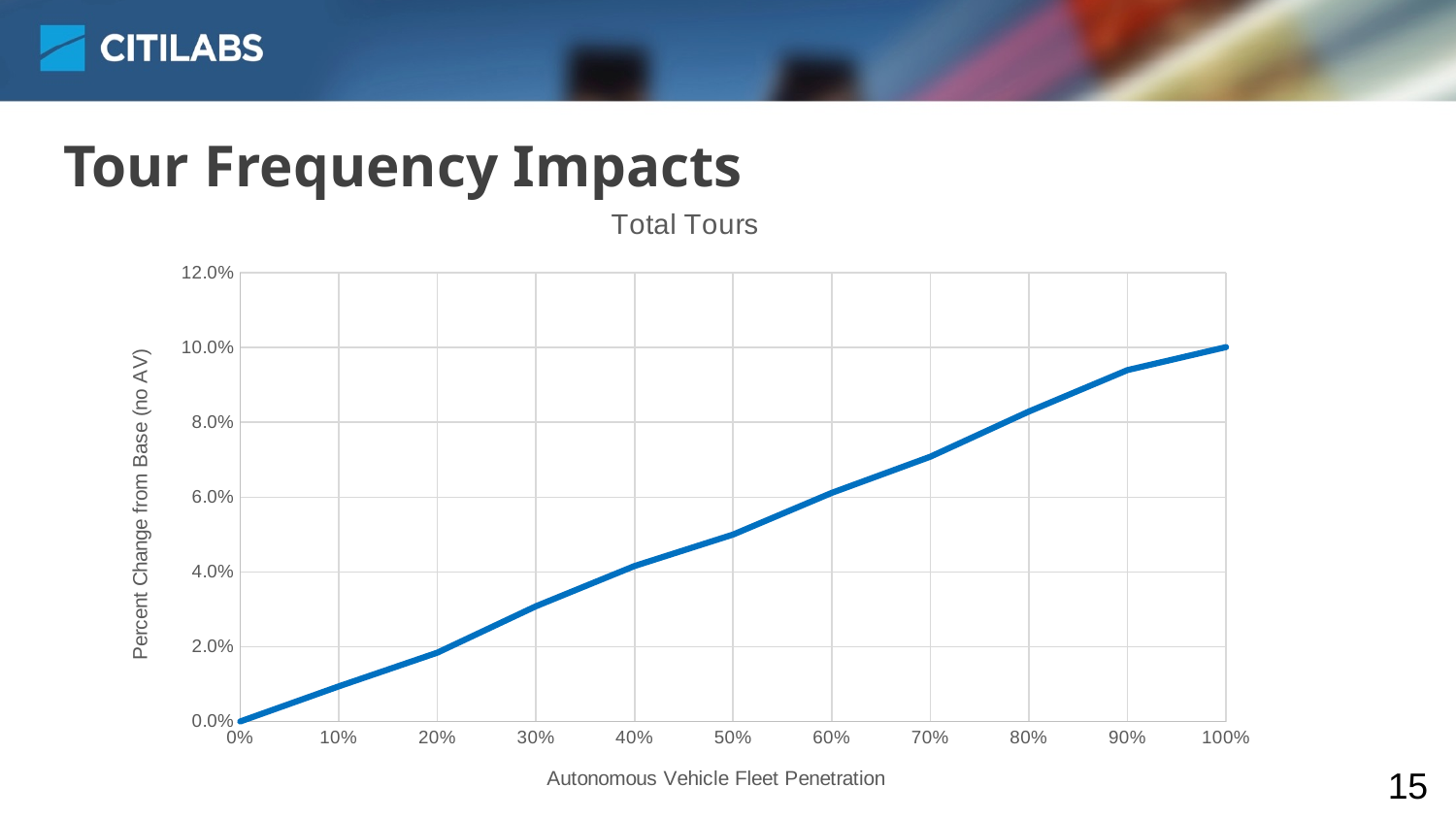
Is the percent change from base at 50% fleet penetration greater or less than 6.0%? less Is the percent change from base at 30% fleet penetration greater or less than 2.0%? greater What kind of chart is shown on the slide? line chart Which has a larger percent change from base: 80% fleet penetration or 40% fleet penetration? 80% At which fleet penetration level is the percent change from base lowest? 0% Does the percent change from base rise or fall as autonomous vehicle fleet penetration increases? rise What is the title of the chart? Total Tours What is the label of the x axis? Autonomous Vehicle Fleet Penetration Is the percent change from base at 70% fleet penetration greater or less than 6.0%? greater What is the percent change from base at 0% fleet penetration? 0.0% At which fleet penetration level is the percent change from base highest? 100%